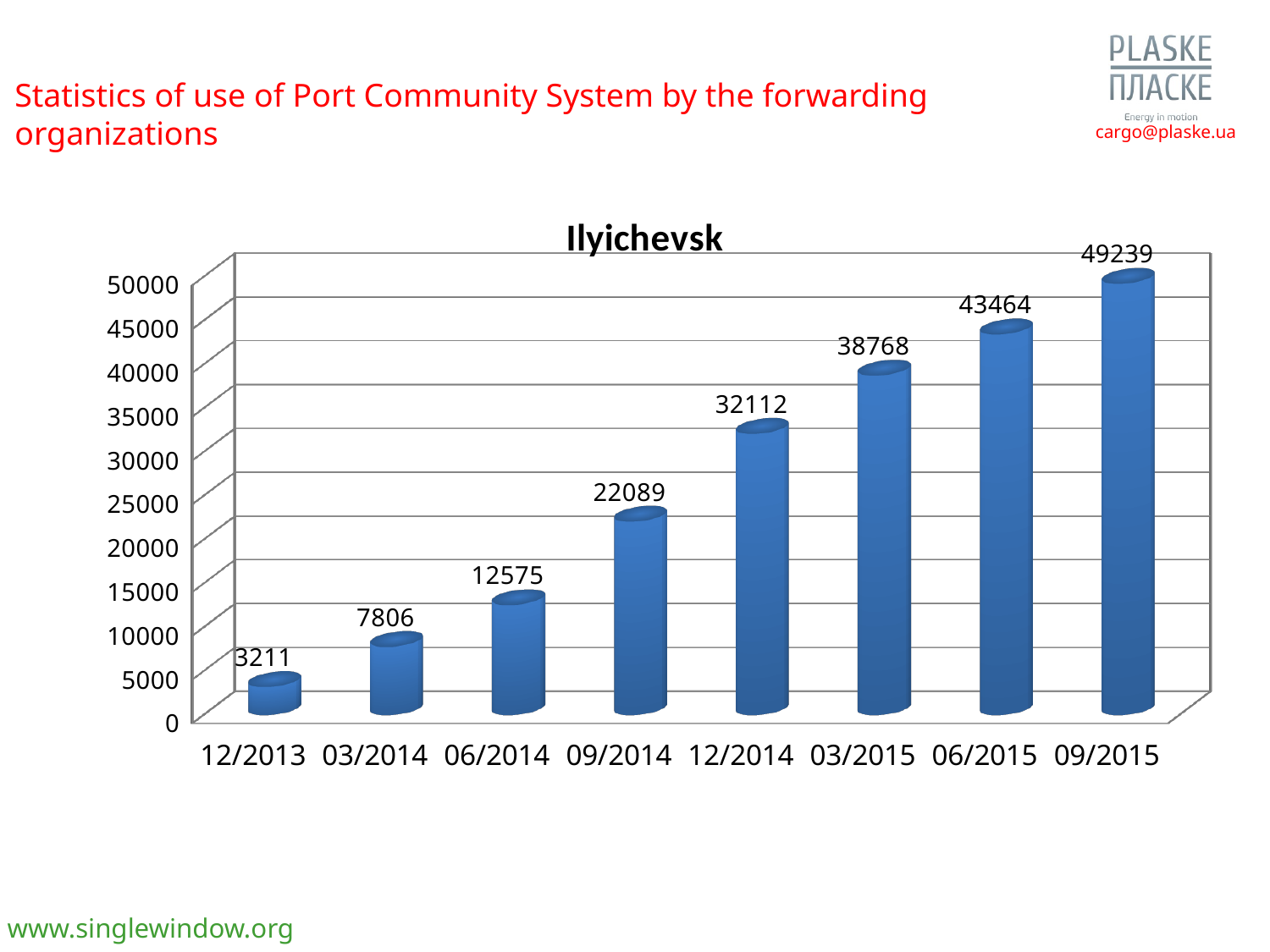
How many periods are shown on the x axis? 8 What is the value for 12/2013? 3211 What is the difference between the values for 09/2015 and 06/2015? 5775 Do the values rise or fall from 12/2013 to 09/2015? rise Is the value for 12/2014 greater or less than 30000? greater What is the value for 03/2015? 38768 What kind of chart is shown? bar chart Which period has the highest value? 09/2015 Which period has the lowest value? 12/2013 What is the value for 09/2014? 22089 Which is larger, the value for 06/2014 or the value for 03/2014? 06/2014 What is the difference between the values for 12/2014 and 09/2014? 10023